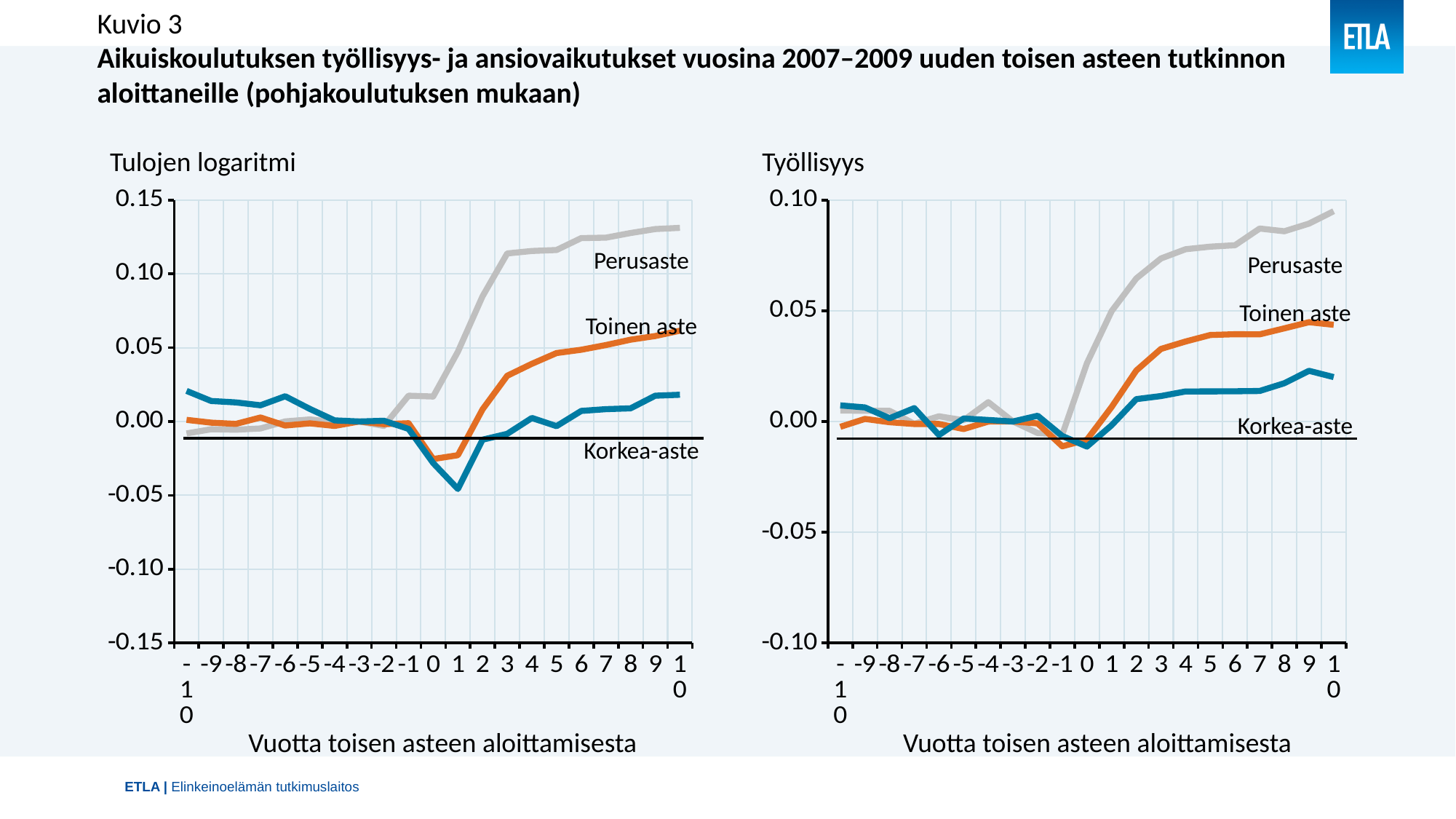
On the 'Tulojen logaritmi' chart, is the value for Korkea-aste at year 1 greater or less than 0.00? less On the 'Työllisyys' chart, is the value for Perusaste at year 10 greater or less than 0.05? greater What is the x-axis label of the 'Työllisyys' chart? Vuotta toisen asteen aloittamisesta How many series are plotted on the 'Työllisyys' chart? 3 On the 'Työllisyys' chart, is the value for Korkea-aste at year 10 greater or less than 0.05? less On the 'Työllisyys' chart, which series has the highest value at year 10? Perusaste On the 'Tulojen logaritmi' chart, which series has the highest value at year 10? Perusaste On the 'Työllisyys' chart, does the Perusaste series rise or fall between year 0 and year 10? rise On the 'Tulojen logaritmi' chart, which series has the lowest value at year 1? Korkea-aste On the 'Tulojen logaritmi' chart, which is larger at year 10: Toinen aste or Korkea-aste? Toinen aste What kind of chart is the 'Tulojen logaritmi' chart? line chart